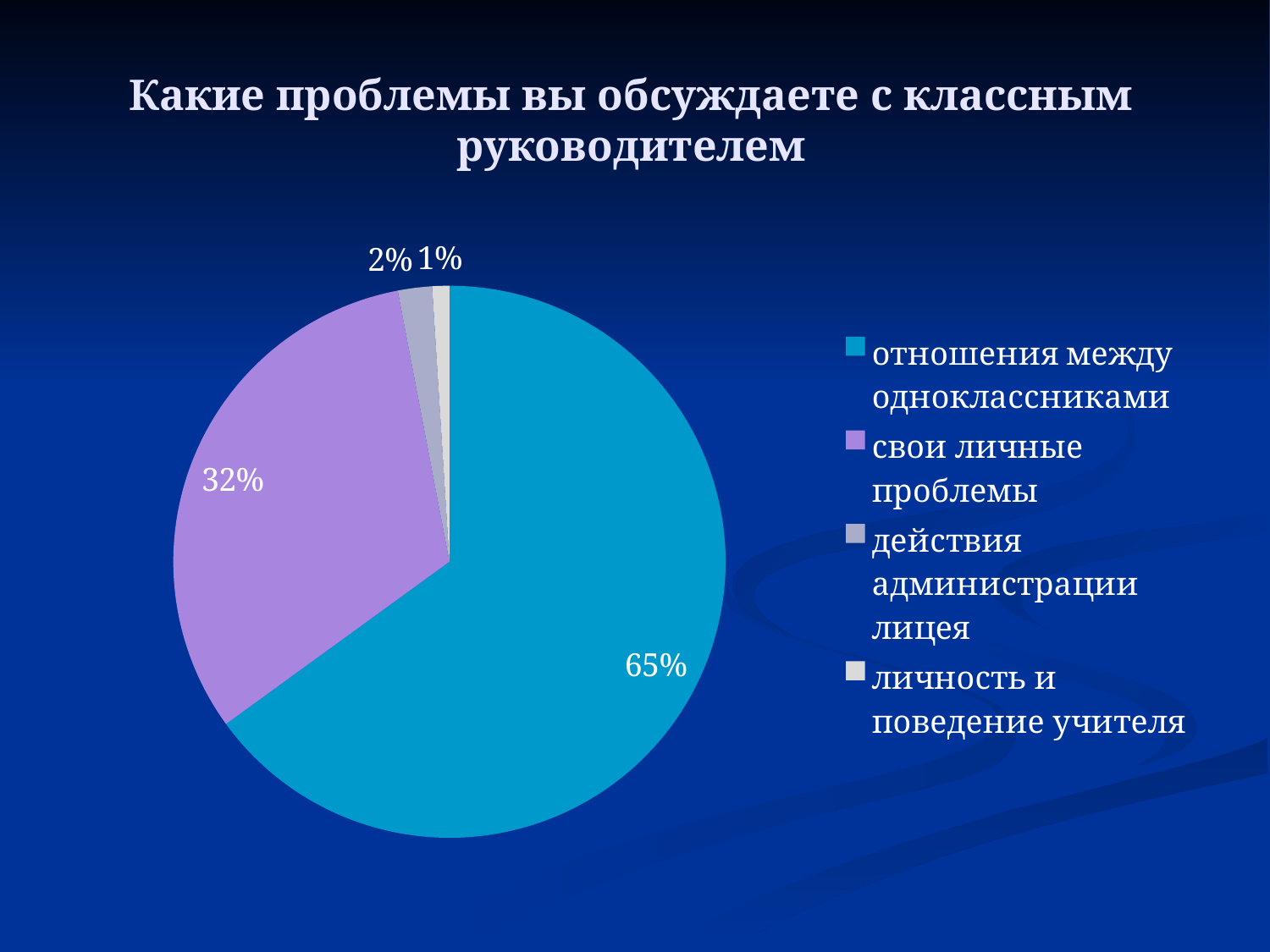
What is the title of the chart on the slide? Какие проблемы вы обсуждаете с классным руководителем What share of the pie is labelled for "отношения между одноклассниками"? 65% What type of chart is shown on the slide? pie chart Which category has the largest slice of the pie? отношения между одноклассниками Which is larger: the slice for "свои личные проблемы" or the slice for "действия администрации лицея"? свои личные проблемы What share of the pie is labelled for "свои личные проблемы"? 32% Which category has the smallest slice of the pie? личность и поведение учителя What share of the pie is labelled for "личность и поведение учителя"? 1% What colour is the slice for "свои личные проблемы"? purple What share of the pie is labelled for "действия администрации лицея"? 2% How many categories does the pie chart show? 4 What is the difference in percentage points between "отношения между одноклассниками" and "свои личные проблемы"? 33